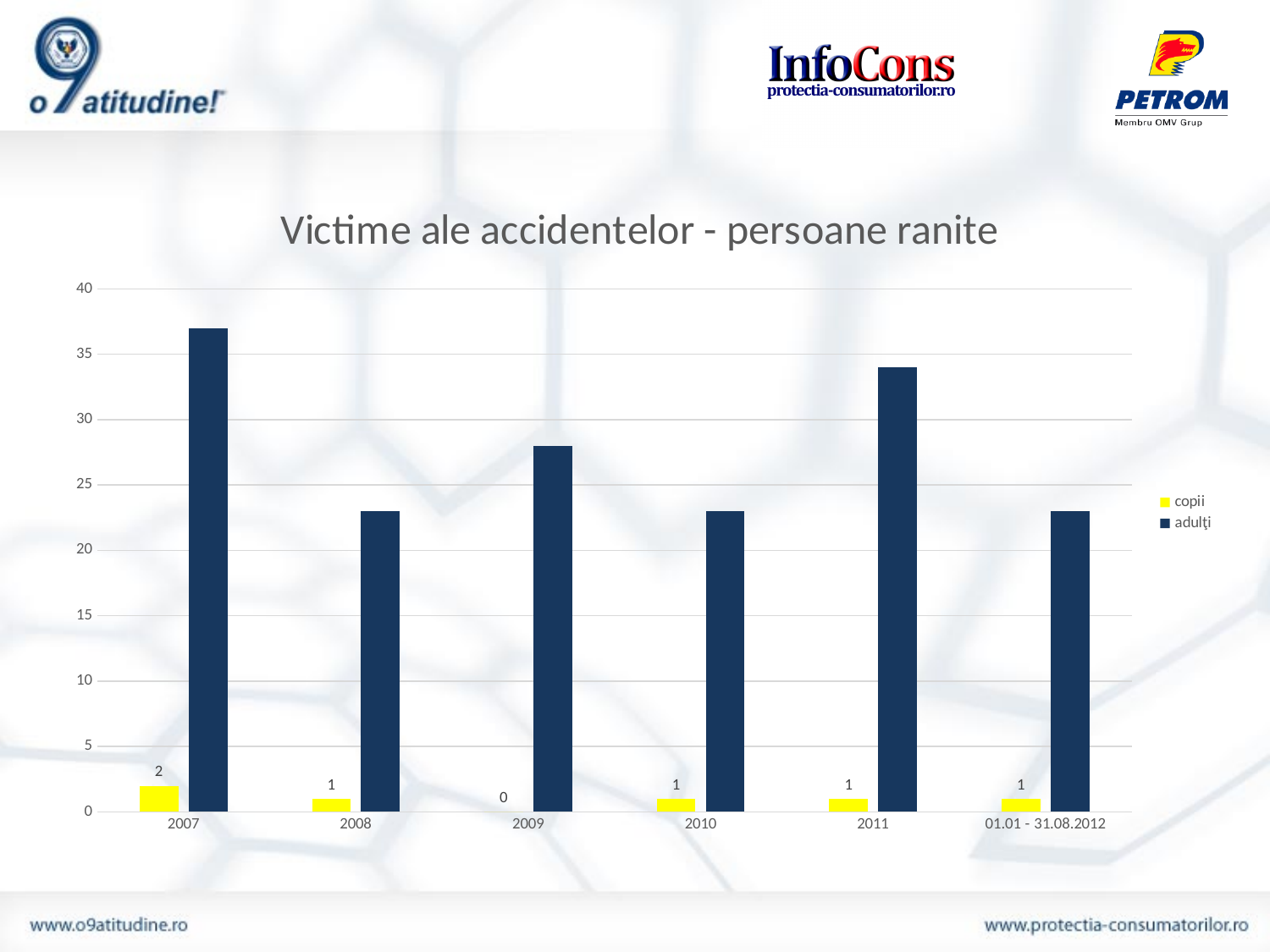
Is the value for adulţi in 2011 greater or less than 30? greater What is the value for copii in 2007? 2 How many categories are shown on the x axis? 6 What is the value for copii in the period 01.01 - 31.08.2012? 1 Is the value for adulţi in 2007 greater or less than 35? greater Which is larger, the adulţi value for 2007 or for 2009? 2007 What is the difference between the copii values for 2007 and 2008? 1 Is the value for adulţi in 2008 greater or less than 25? less Which year has the lowest value for copii? 2009 How many series does the legend list? 2 Which year has the highest value for copii? 2007 What is the value for copii in 2009? 0